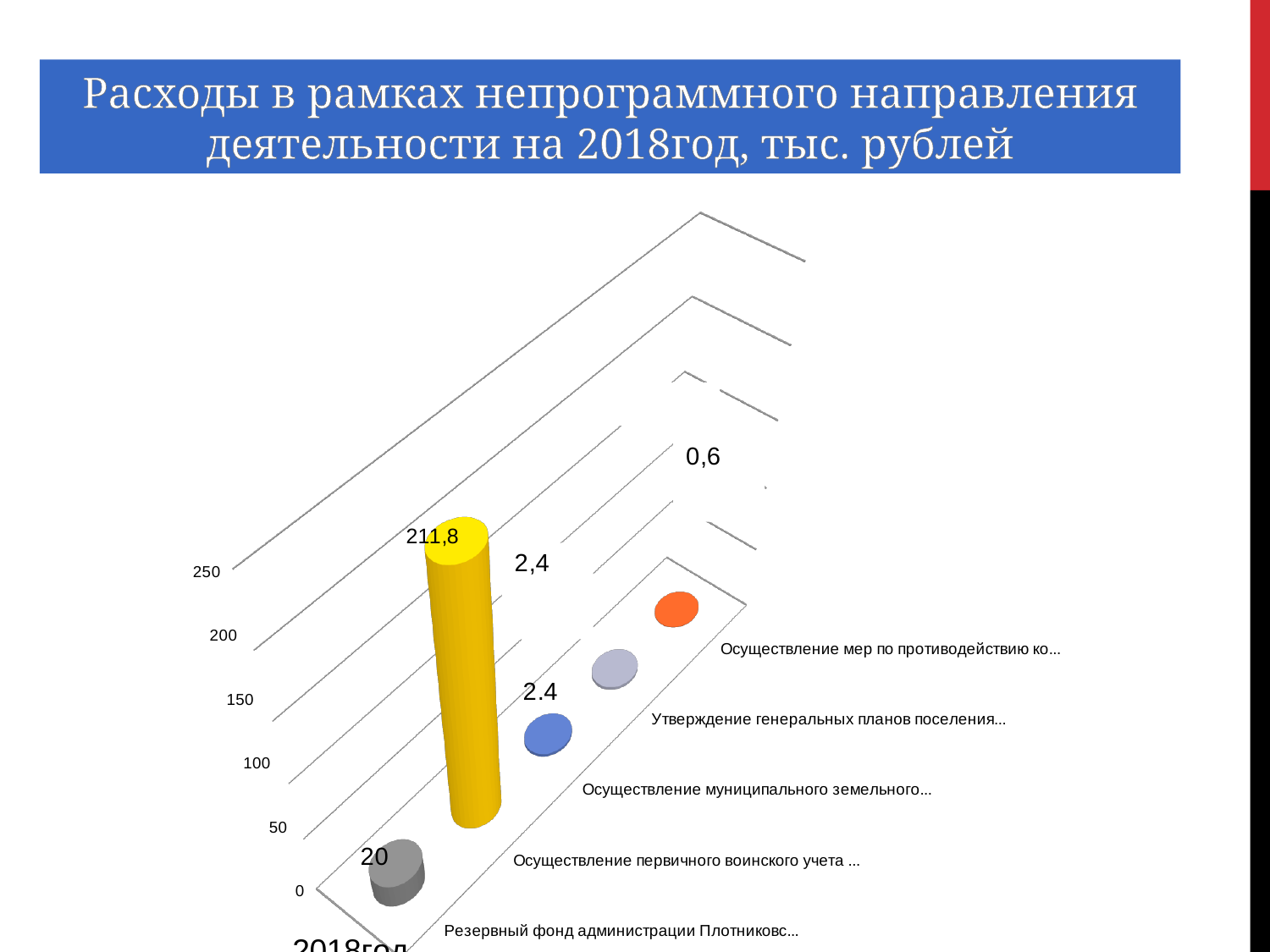
What is the value for Осуществление мер по противодействию ко...? 0,6 What is the highest tick value shown on the vertical axis? 250 How many categories are shown in the chart? 5 What is the difference between the values for Осуществление первичного воинского учета and Резервный фонд администрации Плотниковс...? 191,8 What is the value for Осуществление первичного воинского учета? 211,8 What is the value for Резервный фонд администрации Плотниковс...? 20 Which category has the highest value? Осуществление первичного воинского учета Which category has the lowest value? Осуществление мер по противодействию ко... Which is larger: the value for Резервный фонд администрации Плотниковс... or the value for Утверждение генеральных планов поселения? Резервный фонд администрации Плотниковс... What kind of chart is shown on the slide? bar chart Is the value for Осуществление первичного воинского учета greater or less than 200? greater What is the value for Утверждение генеральных планов поселения? 2,4